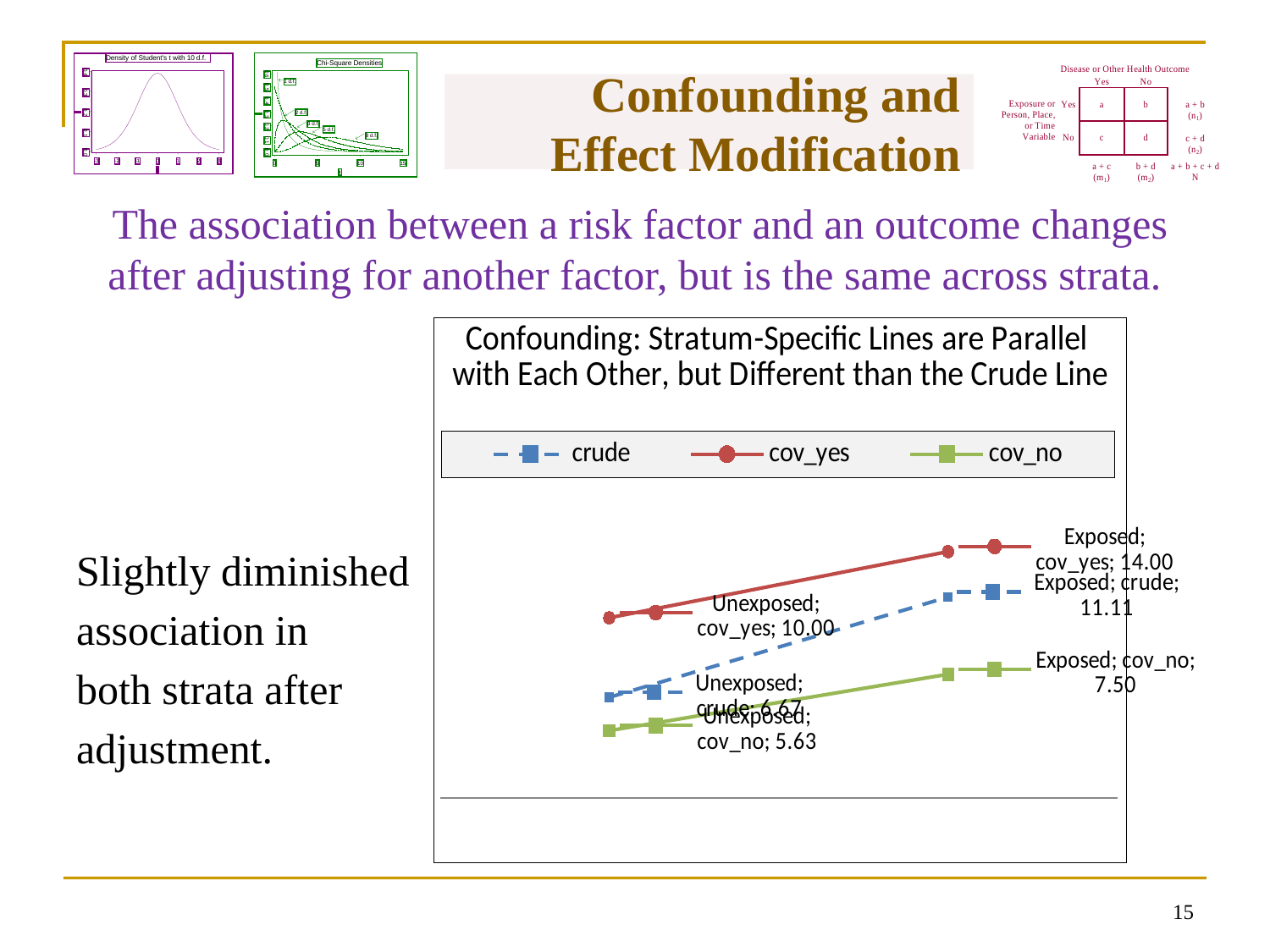
What is the value for Exposed in the crude series? 11.11 How many series does the legend list? 3 What is the value for Unexposed in the cov_yes series? 10.00 What is the value for Exposed in the cov_no series? 7.50 Which is larger: the Exposed value for crude or the Exposed value for cov_no? crude What is the difference between the Exposed and Unexposed values in the cov_yes series? 4.00 Which series has the highest value for Exposed? cov_yes What is the value for Exposed in the cov_yes series? 14.00 What is the value for Unexposed in the crude series? 6.67 What is the value for Unexposed in the cov_no series? 5.63 What kind of chart is shown on the slide? line chart Which series has the lowest value for Unexposed? cov_no